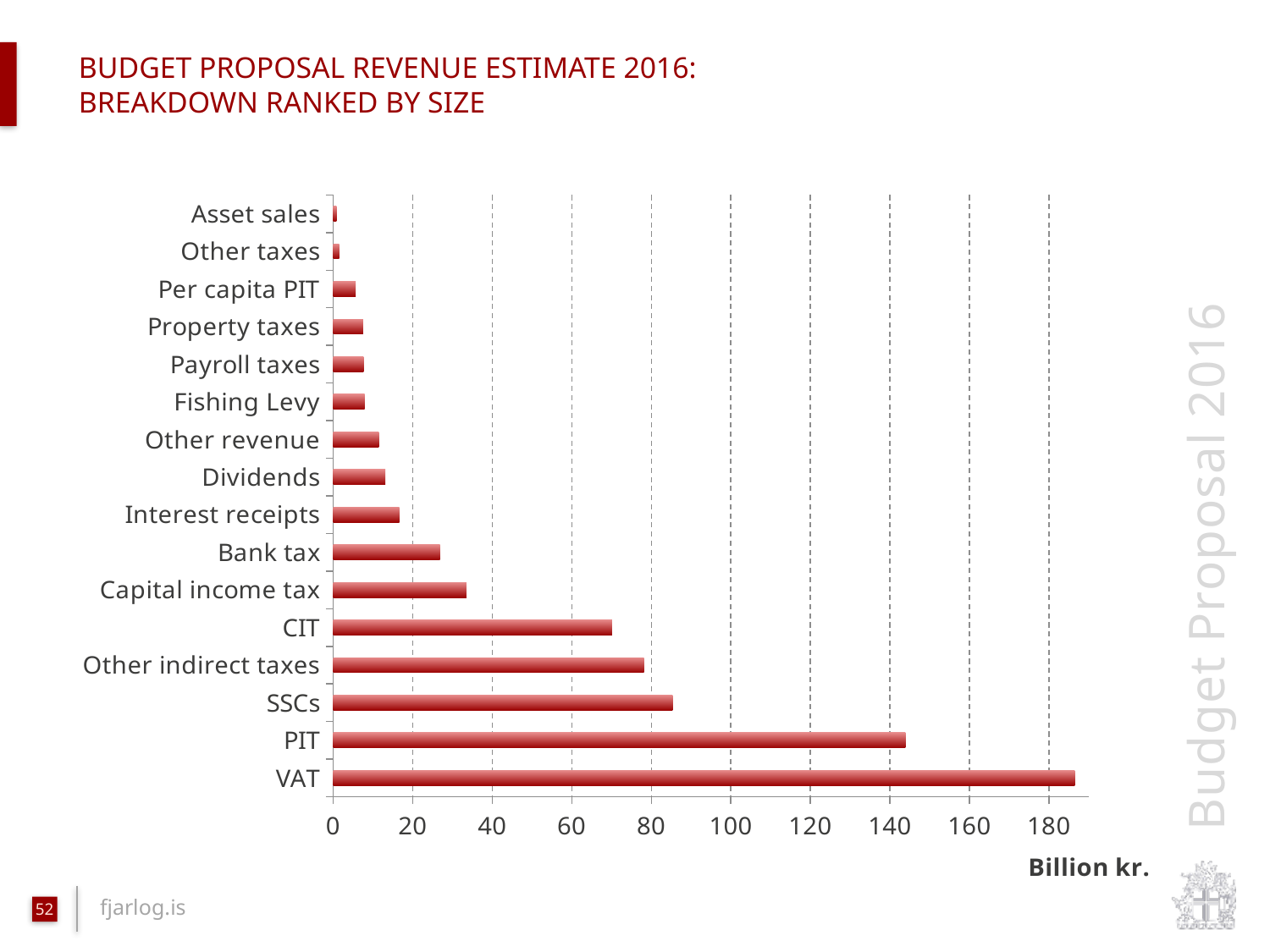
What unit is shown on the horizontal axis of the chart? Billion kr. Which revenue category has the largest value? VAT How many revenue categories are plotted in the chart? 16 Is the value for VAT greater or less than 180? greater What is the title of the slide containing the chart? BUDGET PROPOSAL REVENUE ESTIMATE 2016: BREAKDOWN RANKED BY SIZE Is the value for SSCs greater or less than 100? less Is the value for Bank tax greater or less than 20? greater What kind of chart is shown on the slide? bar chart Which is larger, the value for CIT or the value for Capital income tax? CIT Which revenue category has the smallest value? Asset sales Which is larger, the value for PIT or the value for SSCs? PIT